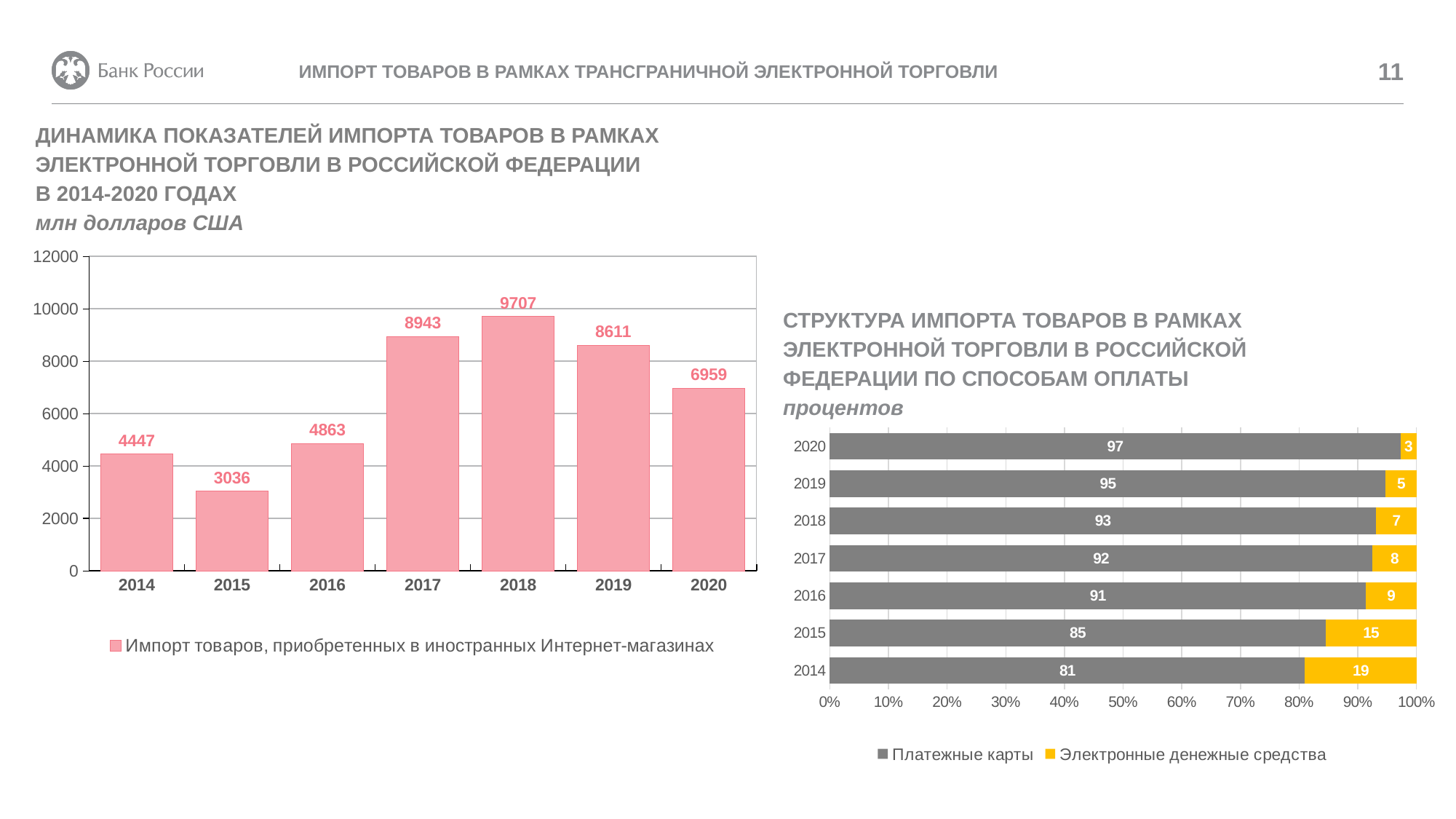
In the left chart (Динамика показателей импорта товаров), which is larger: the value for 2017 or the value for 2019? 2017 In the right chart (Структура импорта товаров по способам оплаты), what is the share of Платежные карты in 2014? 81 In the left chart (Динамика показателей импорта товаров), what is the value for 2018? 9707 In the left chart (Динамика показателей импорта товаров), what is the difference between the values for 2018 and 2020? 2748 In the left chart (Динамика показателей импорта товаров), which year has the lowest value? 2015 In the left chart (Динамика показателей импорта товаров), which year has the highest value? 2018 In the right chart (Структура импорта товаров по способам оплаты), does the share of Электронные денежные средства rise or fall from 2014 to 2020? Fall In the right chart (Структура импорта товаров по способам оплаты), how many series does the legend list? 2 What kind of chart is the left chart (Динамика показателей импорта товаров)? Bar chart In the left chart (Динамика показателей импорта товаров), what is the value for 2015? 3036 In the left chart (Динамика показателей импорта товаров), how many years are shown on the x axis? 7 In the right chart (Структура импорта товаров по способам оплаты), what is the share of Электронные денежные средства in 2019? 5